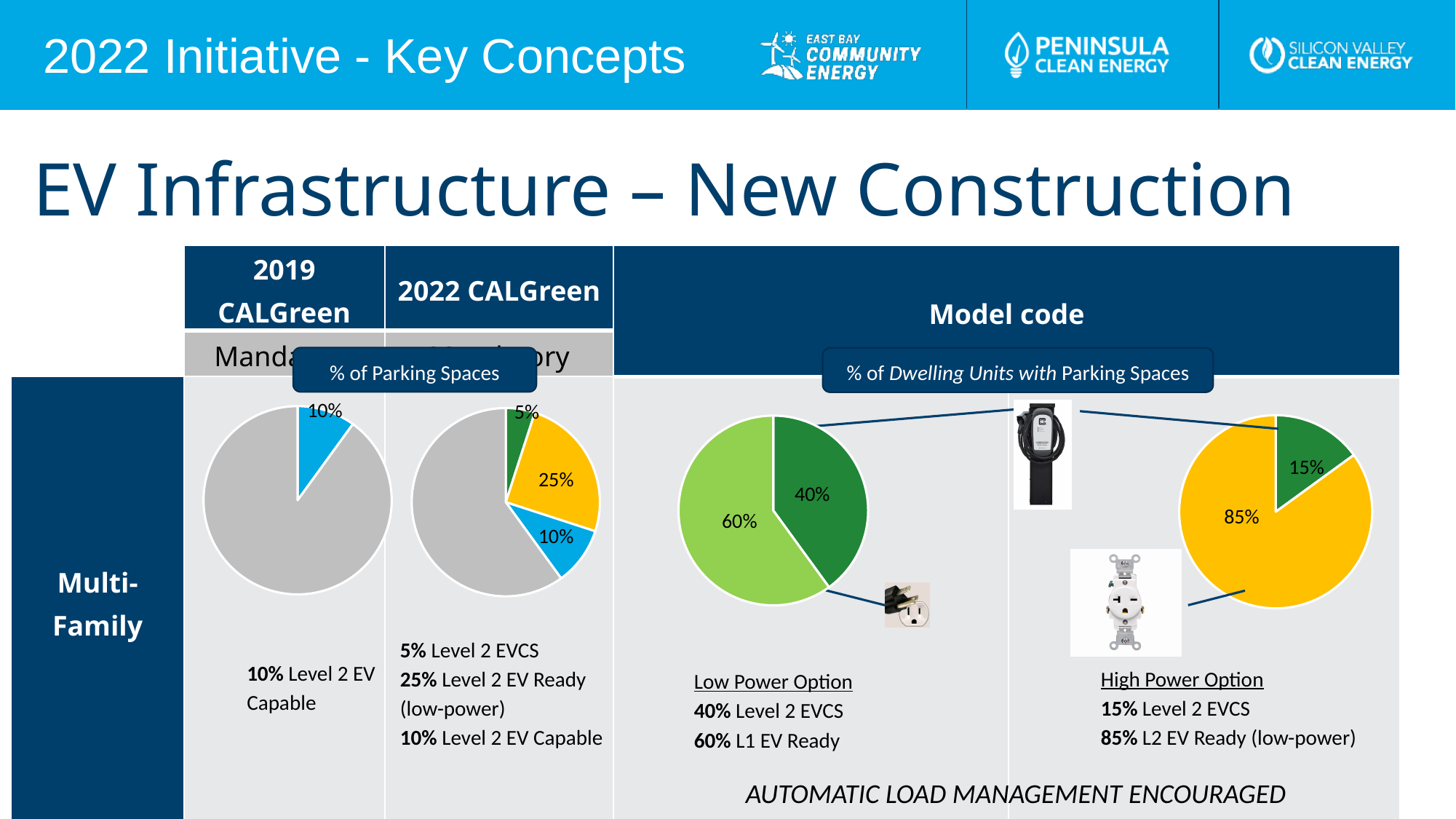
In the 2022 CALGreen pie chart, what is the combined total of the three labelled slices (5%, 25% and 10%)? 40% In the 2022 CALGreen pie chart, which labelled slice is the smallest? 5% Level 2 EVCS Which is larger: the Level 2 EVCS share in the Low Power Option pie chart or the Level 2 EVCS share in the High Power Option pie chart? Low Power Option (40%) In the Model code Low Power Option pie chart, what percentage is shown for L1 EV Ready? 60% In the Model code Low Power Option pie chart, what is the difference between the L1 EV Ready share and the Level 2 EVCS share? 20% What type of chart is used to show the Multi-Family EV infrastructure requirements on this slide? Pie chart In the 2022 CALGreen pie chart, what percentage is shown for Level 2 EVCS? 5% In the Model code High Power Option pie chart, what percentage is shown for Level 2 EVCS? 15% How many pie charts are shown on the slide? 4 In the 2022 CALGreen pie chart, what percentage is shown for Level 2 EV Ready (low-power)? 25% In the 2019 CALGreen pie chart, what percentage is shown for Level 2 EV Capable? 10% In the Model code High Power Option pie chart, which slice is the largest? 85% L2 EV Ready (low-power)